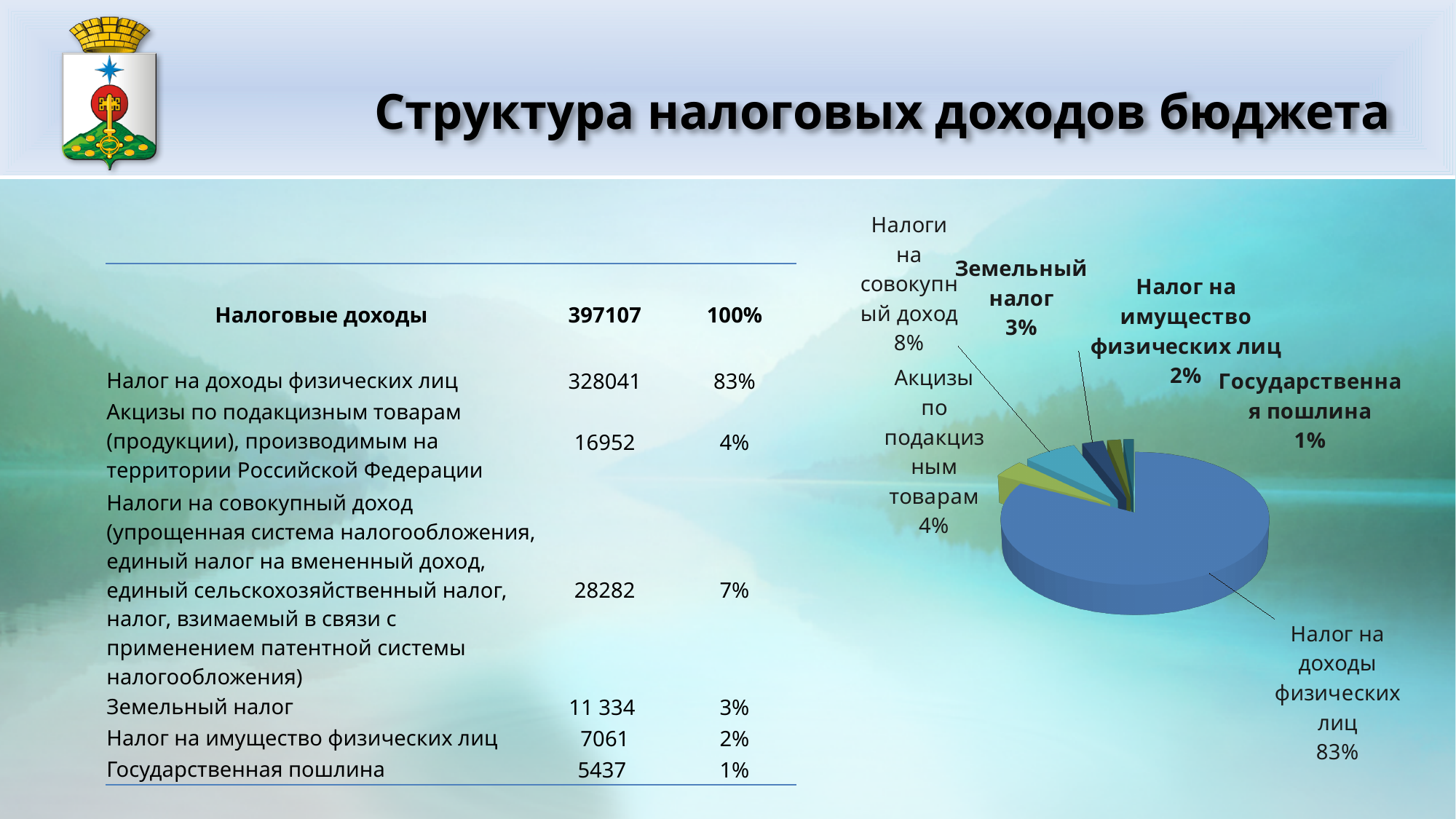
What kind of chart is shown on the slide? Pie chart How many slices does the pie chart have? 6 Which slice of the pie chart is the largest? Налог на доходы физических лиц What share of the pie does "Налог на доходы физических лиц" have? 83% Which slice of the pie chart is the smallest? Государственная пошлина Which is larger in the pie chart: "Налоги на совокупный доход" or "Акцизы по подакцизным товарам"? Налоги на совокупный доход What share of the pie does "Земельный налог" have? 3% What share of the pie does "Акцизы по подакцизным товарам" have? 4% What is the difference in percentage points between the "Налог на доходы физических лиц" slice and the "Налоги на совокупный доход" slice? 75%